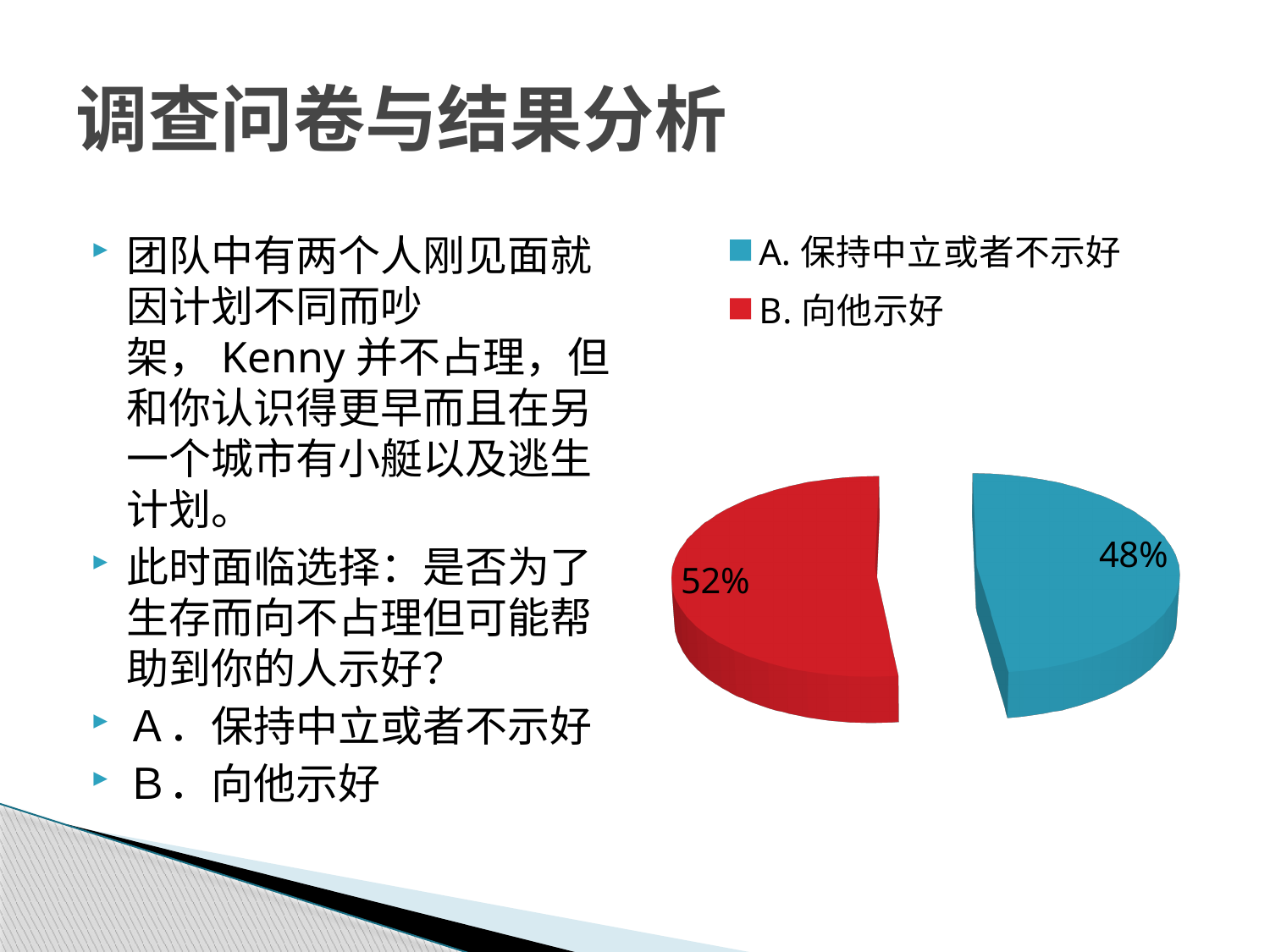
What colour is the slice for "B. 向他示好"? red Is the share for "A. 保持中立或者不示好" greater or less than 50%? less How many slices does the pie chart have? 2 Which is larger, the share for A or the share for B? B. 向他示好 What share of the pie does "A. 保持中立或者不示好" have? 48% What kind of chart is shown on the slide? pie chart Which slice of the pie is the largest? B. 向他示好 How many entries does the legend list? 2 What is the difference in percentage points between the B slice and the A slice? 4% Which slice of the pie is the smallest? A. 保持中立或者不示好 What colour is the slice for "A. 保持中立或者不示好"? blue What share of the pie does "B. 向他示好" have? 52%